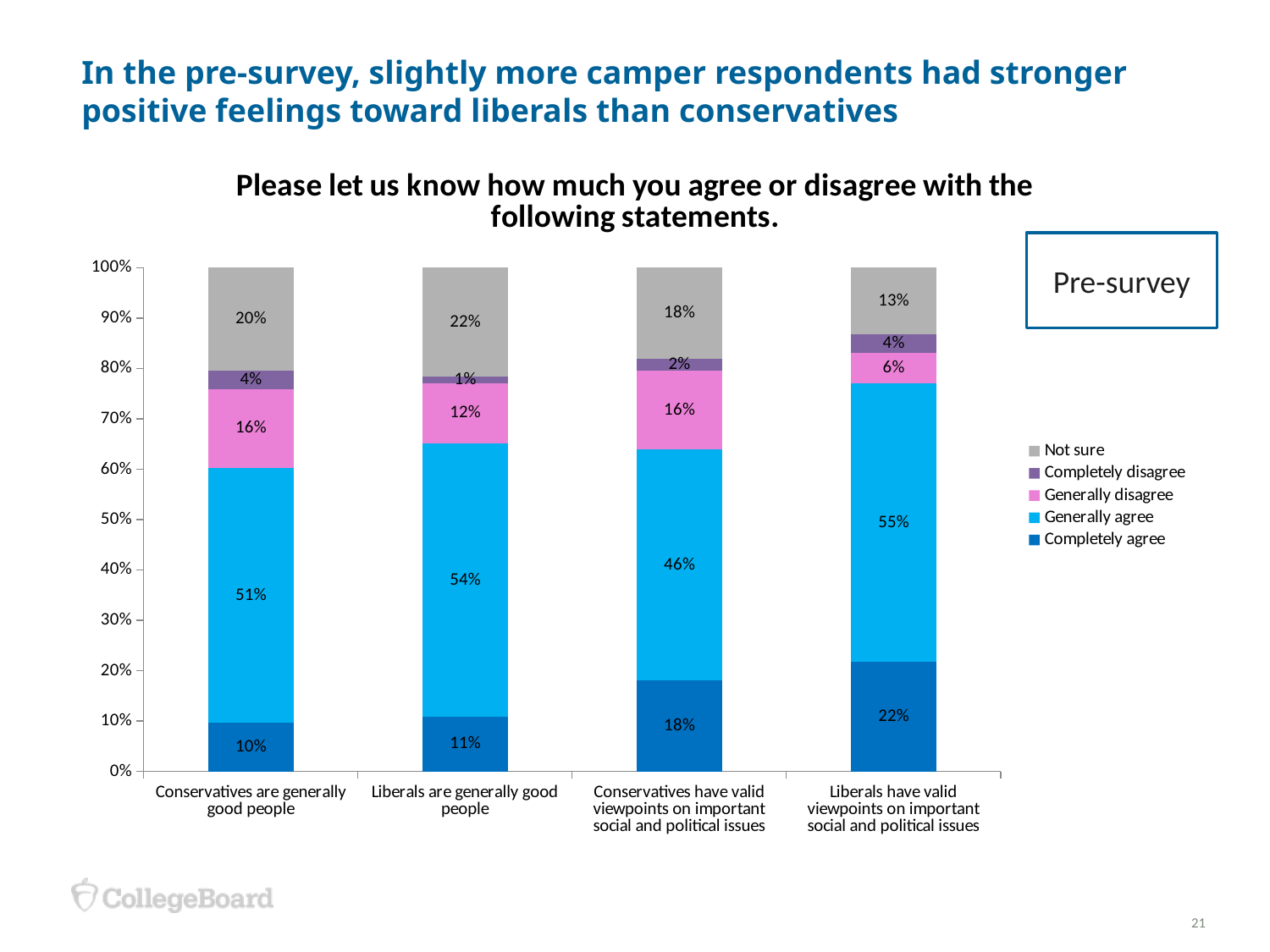
What percentage generally agree that conservatives have valid viewpoints on important social and political issues? 46% What percentage of respondents completely agree that liberals have valid viewpoints on important social and political issues? 22% How many series does the legend list? 5 What kind of chart is shown on the slide? Stacked bar chart Which is larger: the 'Generally disagree' value for 'Conservatives have valid viewpoints on important social and political issues' or for 'Liberals have valid viewpoints on important social and political issues'? Conservatives have valid viewpoints on important social and political issues What is the 'Completely disagree' value for 'Liberals are generally good people'? 1% What is the 'Not sure' value for the statement 'Liberals are generally good people'? 22% What is the title of the chart? Please let us know how much you agree or disagree with the following statements. Which statement has the lowest 'Not sure' percentage? Liberals have valid viewpoints on important social and political issues How many statements (categories) are shown on the x axis? 4 Which statement has the highest 'Completely agree' percentage? Liberals have valid viewpoints on important social and political issues What is the difference between the 'Generally agree' values for 'Liberals are generally good people' and 'Conservatives are generally good people'? 3%